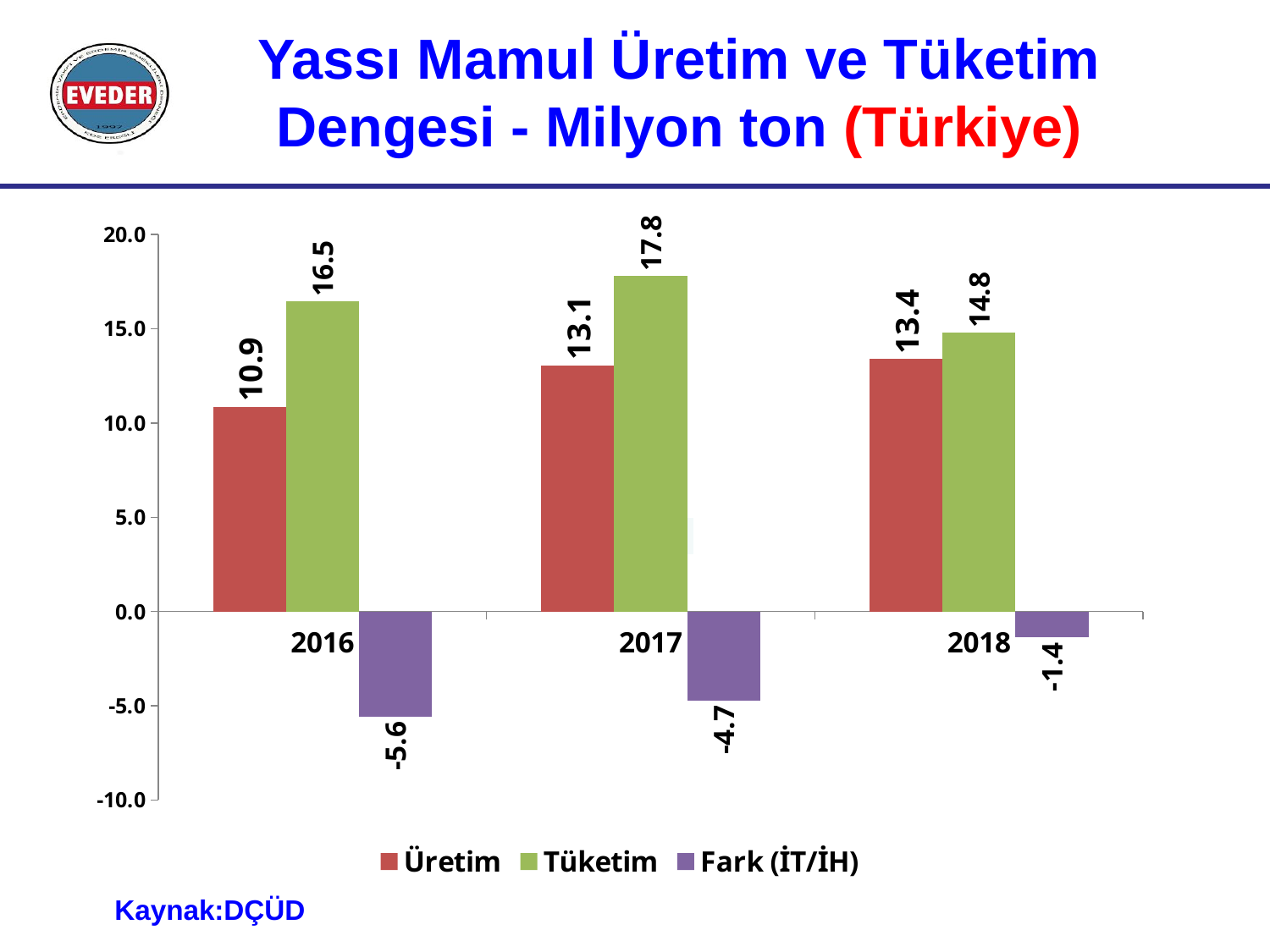
How many years are shown on the x axis? 3 Is the Tüketim value for 2017 greater or less than 15.0? greater What is the difference between Tüketim and Üretim in 2018? 1.4 In which year is Tüketim highest? 2017 Which is larger in 2016, Üretim or Tüketim? Tüketim How many series does the legend list? 3 What is the Tüketim value for 2016? 16.5 Does the Üretim value rise or fall from 2016 to 2018? rise In which year is Üretim lowest? 2016 What is the Fark (İT/İH) value for 2018? -1.4 What is the Üretim value for 2017? 13.1 What kind of chart is shown on the slide? bar chart